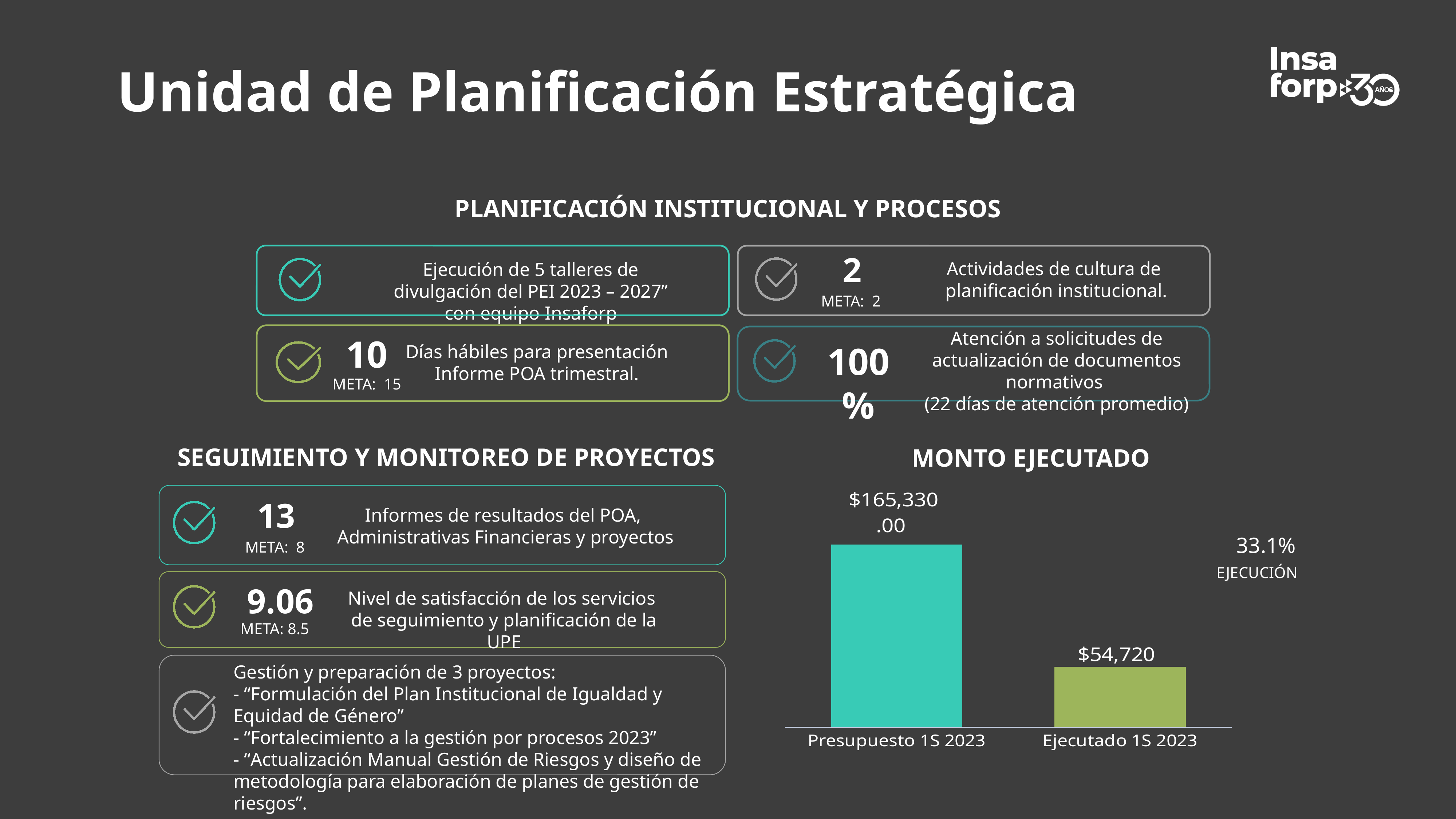
How many bars are shown in the MONTO EJECUTADO chart? 2 Do the values in the MONTO EJECUTADO chart rise or fall from left to right? fall In the MONTO EJECUTADO chart, what is the difference between the Presupuesto 1S 2023 and Ejecutado 1S 2023 values? $110,610 What is the value of the Ejecutado 1S 2023 bar in the MONTO EJECUTADO chart? $54,720 What is the value of the Presupuesto 1S 2023 bar in the MONTO EJECUTADO chart? $165,330.00 Which category has the lowest value in the MONTO EJECUTADO chart? Ejecutado 1S 2023 Which category has the highest value in the MONTO EJECUTADO chart? Presupuesto 1S 2023 What kind of chart is the MONTO EJECUTADO chart? bar chart In the MONTO EJECUTADO chart, is the value for Presupuesto 1S 2023 larger or smaller than the value for Ejecutado 1S 2023? larger What execution percentage (EJECUCIÓN) is shown next to the MONTO EJECUTADO chart? 33.1% What is the title of the chart on the slide? MONTO EJECUTADO